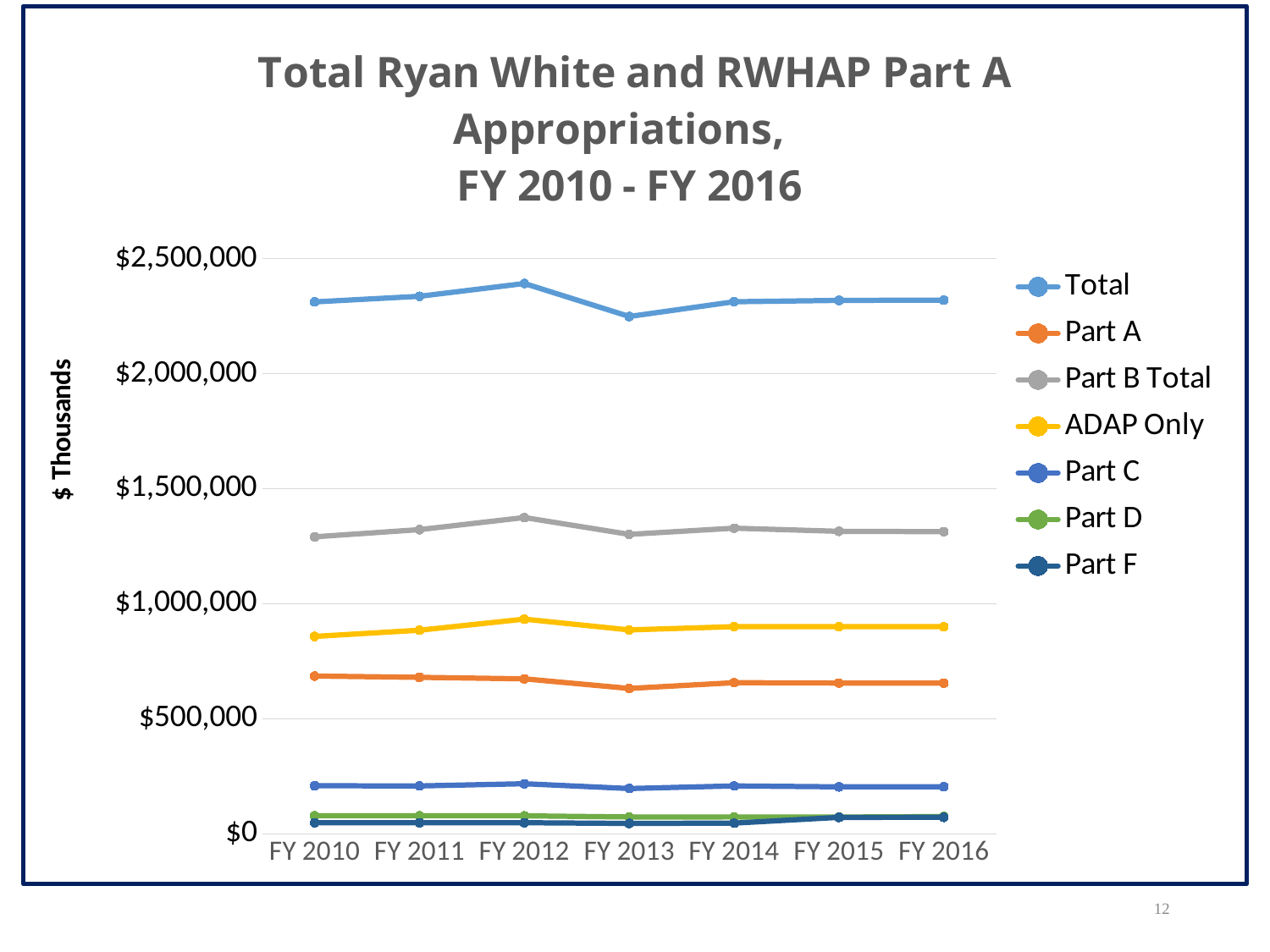
In which fiscal year is the Total series at its lowest? FY 2013 What is the label on the vertical axis? $ Thousands Is the value for Total in FY 2012 greater or less than $2,000,000? greater In which fiscal year is the Part B Total series at its highest? FY 2012 Does the Total series rise or fall from FY 2012 to FY 2013? Fall Which series is larger in FY 2012, Part B Total or ADAP Only? Part B Total How many series does the legend list? 7 In which fiscal year is the Total series at its highest? FY 2012 Is the value for Part B Total in FY 2012 greater or less than $1,500,000? less Is the value for Part A in FY 2010 greater or less than $500,000? greater How many fiscal years are plotted along the x axis? 7 What kind of chart is shown on the slide? Line chart